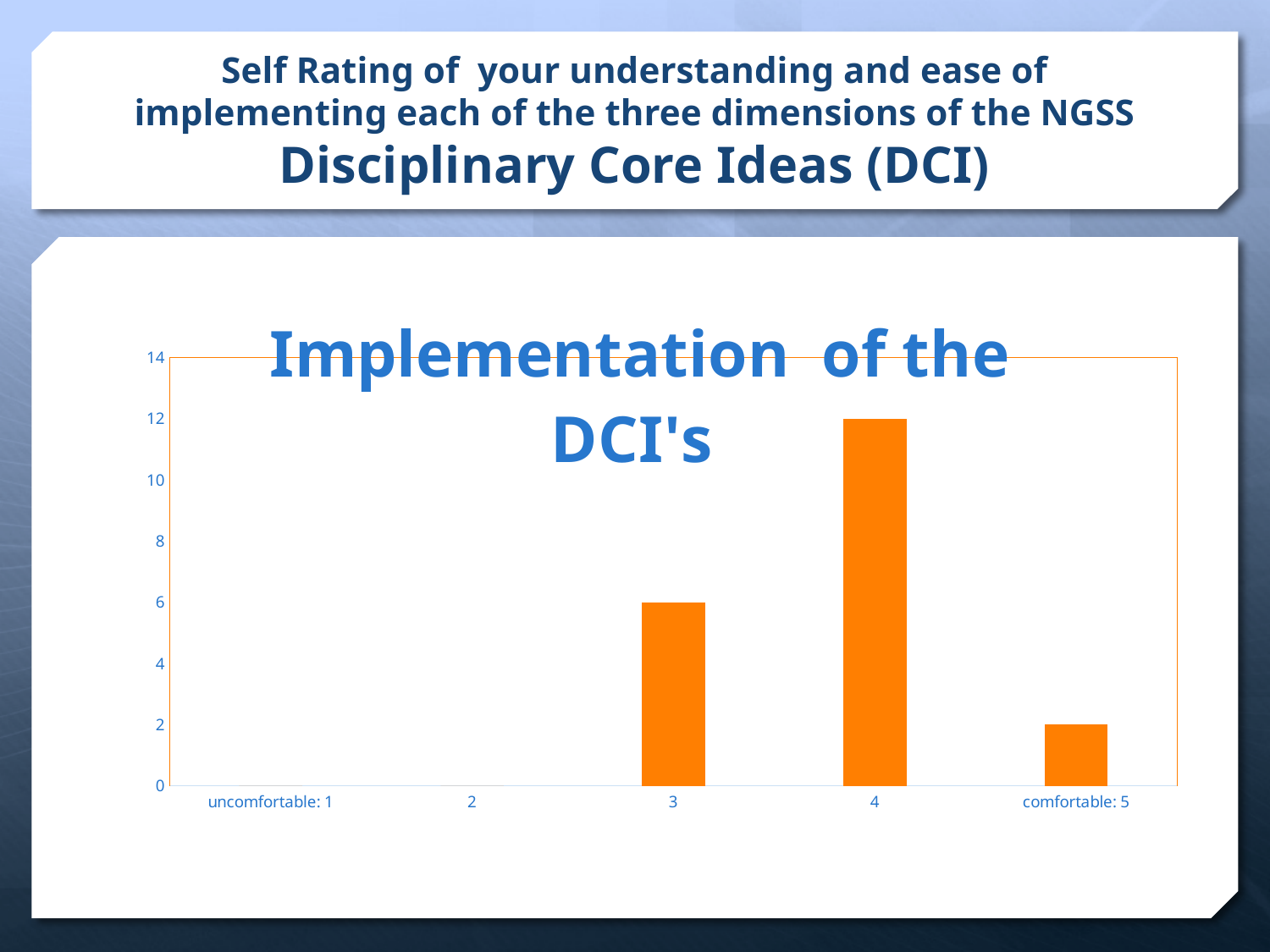
How many categories are shown on the x axis of the chart? 5 What is the title of the chart? Implementation of the DCI's What is the difference between the values for category 4 and category 3? 6 What is the value for 'comfortable: 5'? 2 What is the value for category 3? 6 Is the value for category 4 greater or less than 10? greater Which is larger, the value for category 3 or the value for 'comfortable: 5'? 3 Which category has the lowest value among those with a visible bar? comfortable: 5 Which category has the highest value? 4 What colour are the bars in the chart? orange What type of chart is shown on the slide? bar chart What is the value for category 4? 12